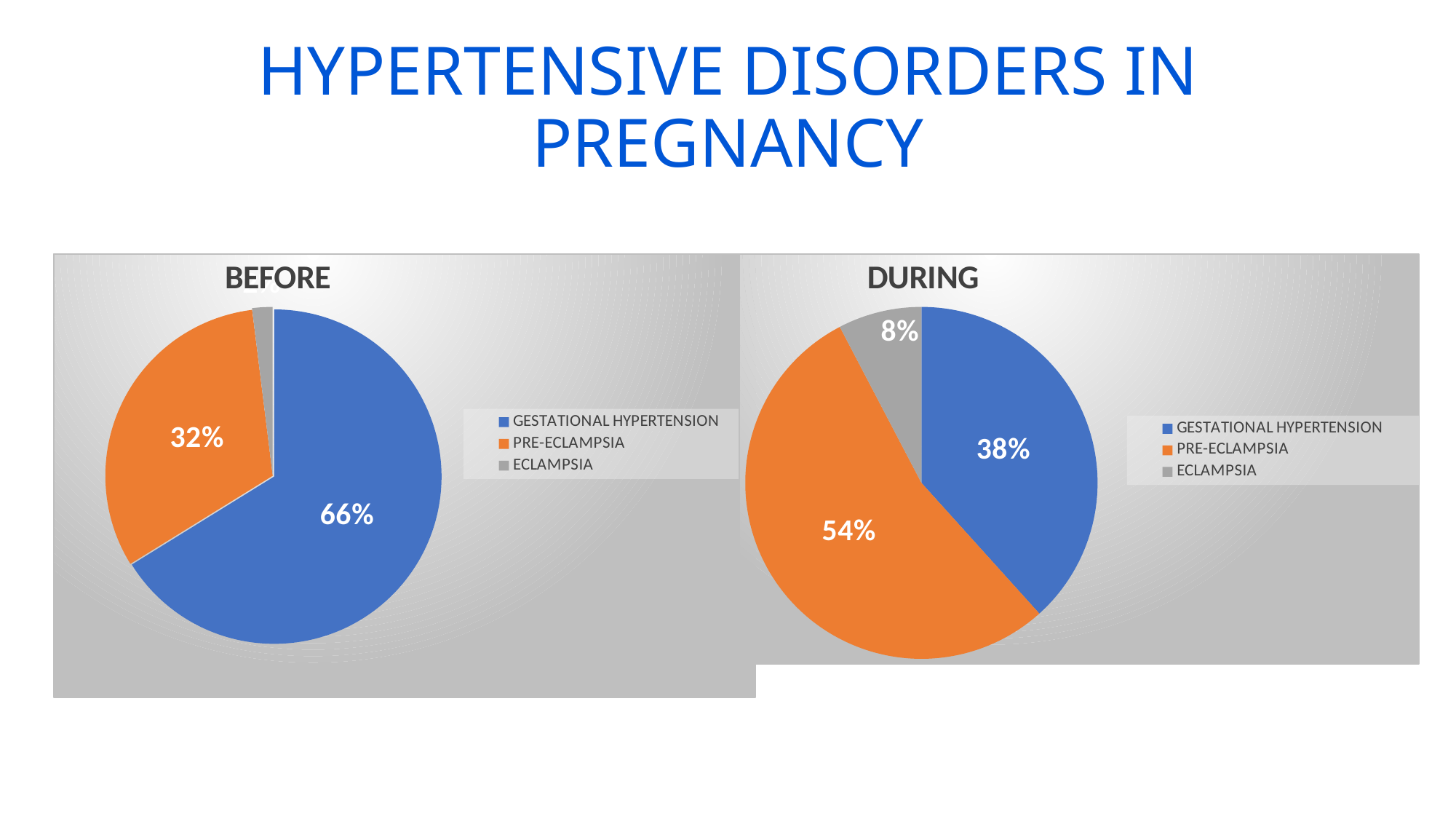
In the BEFORE pie chart, which category has the largest slice? GESTATIONAL HYPERTENSION How many categories does the legend of the DURING chart list? 3 In the DURING pie chart, which category has the smallest slice? ECLAMPSIA In the BEFORE pie chart, what share is labelled for PRE-ECLAMPSIA? 32% In the DURING pie chart, what share is labelled for ECLAMPSIA? 8% What kind of chart is the BEFORE chart? Pie chart In the DURING pie chart, what share is labelled for PRE-ECLAMPSIA? 54% In the BEFORE pie chart, which category has the smallest slice? ECLAMPSIA In the DURING pie chart, what is the difference between the PRE-ECLAMPSIA share and the GESTATIONAL HYPERTENSION share? 16% In the DURING pie chart, which category has the largest slice? PRE-ECLAMPSIA